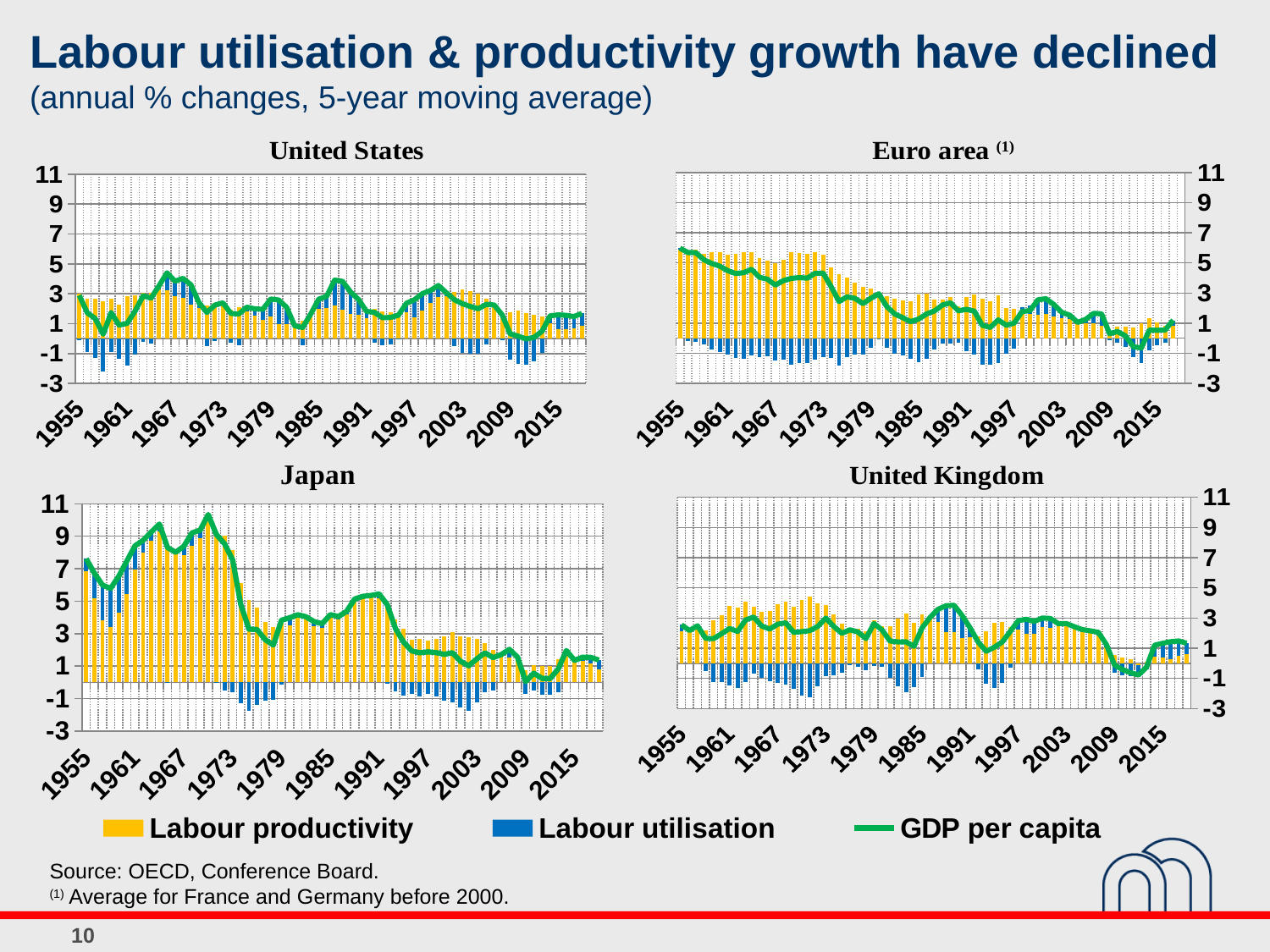
Which of the four charts shows the highest peak in GDP per capita growth? Japan In the legend, which series is shown in blue? Labour utilisation In the Japan chart, does GDP per capita growth overall rise or fall from 1955 to 2015? fall How many series does the legend list? 3 What kind of chart is the United States chart? Combined bar and line chart How many charts are shown on the slide? 4 In the legend, which series is drawn as a green line? GDP per capita In the United States chart, is the GDP per capita value in 1955 greater or less than 5? less In the Euro area chart, is the GDP per capita value in 1955 greater or less than 5? greater In the Japan chart, is the GDP per capita value around 1970 greater or less than 9? greater In the Euro area chart, does GDP per capita growth overall rise or fall from 1955 to 2015? fall